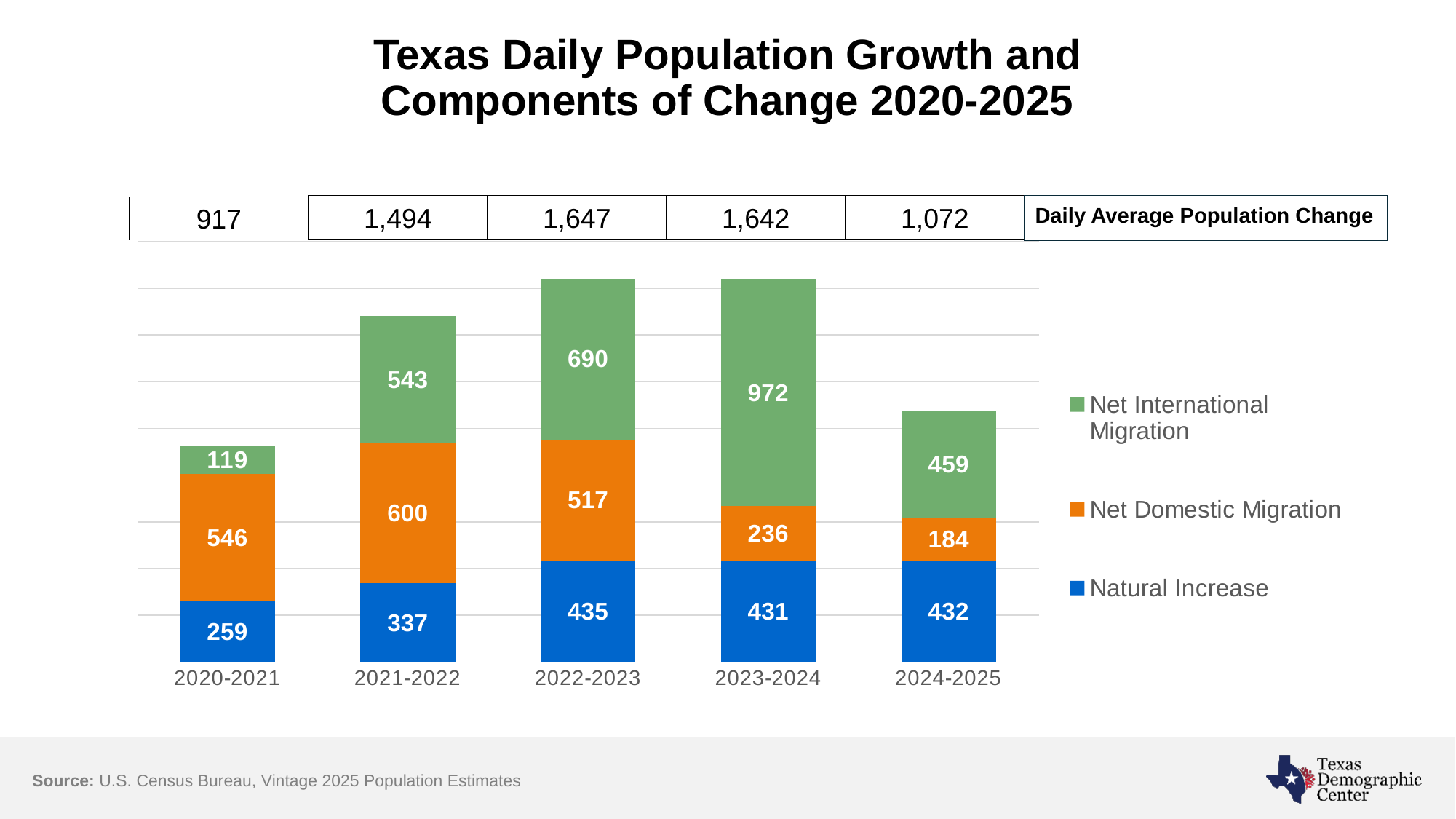
What is the difference between Net Domestic Migration in 2020-2021 and in 2024-2025? 362 What is the Net Domestic Migration value for 2021-2022? 600 What is the Natural Increase value for 2020-2021? 259 What is the Daily Average Population Change shown for 2022-2023? 1,647 What kind of chart is shown on the slide? Stacked bar chart Which is larger: Net International Migration in 2021-2022 or in 2022-2023? 2022-2023 What is the Net International Migration value for 2023-2024? 972 Which period has the highest Net International Migration? 2023-2024 Does Natural Increase rise or fall from 2020-2021 to 2022-2023? Rise Which period has the lowest Net Domestic Migration? 2024-2025 How many series does the legend list? 3 How many time periods are shown on the x axis? 5